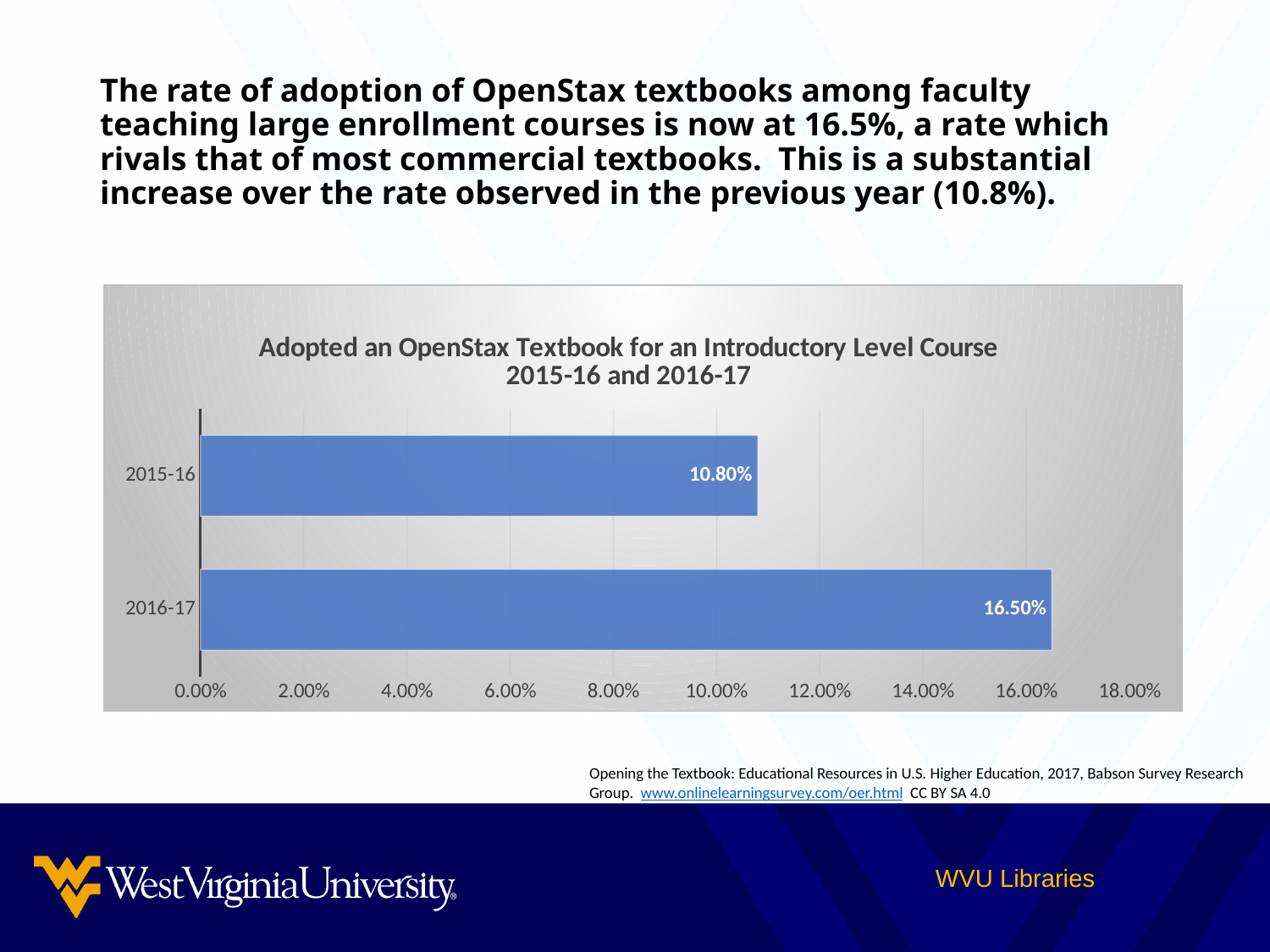
What is the value for 2016-17? 16.50% What is the difference between the values for 2016-17 and 2015-16? 5.70% How many categories are shown in the chart? 2 What is the value for 2015-16? 10.80% What is the title of the chart? Adopted an OpenStax Textbook for an Introductory Level Course 2015-16 and 2016-17 What is the maximum value shown on the x axis? 18.00% Is the value for 2015-16 greater or less than 12.00%? less Which is larger, the value for 2015-16 or the value for 2016-17? 2016-17 Which year has the lowest value? 2015-16 Is the value for 2016-17 greater or less than 14.00%? greater What kind of chart is shown on the slide? bar chart Which year has the highest value? 2016-17